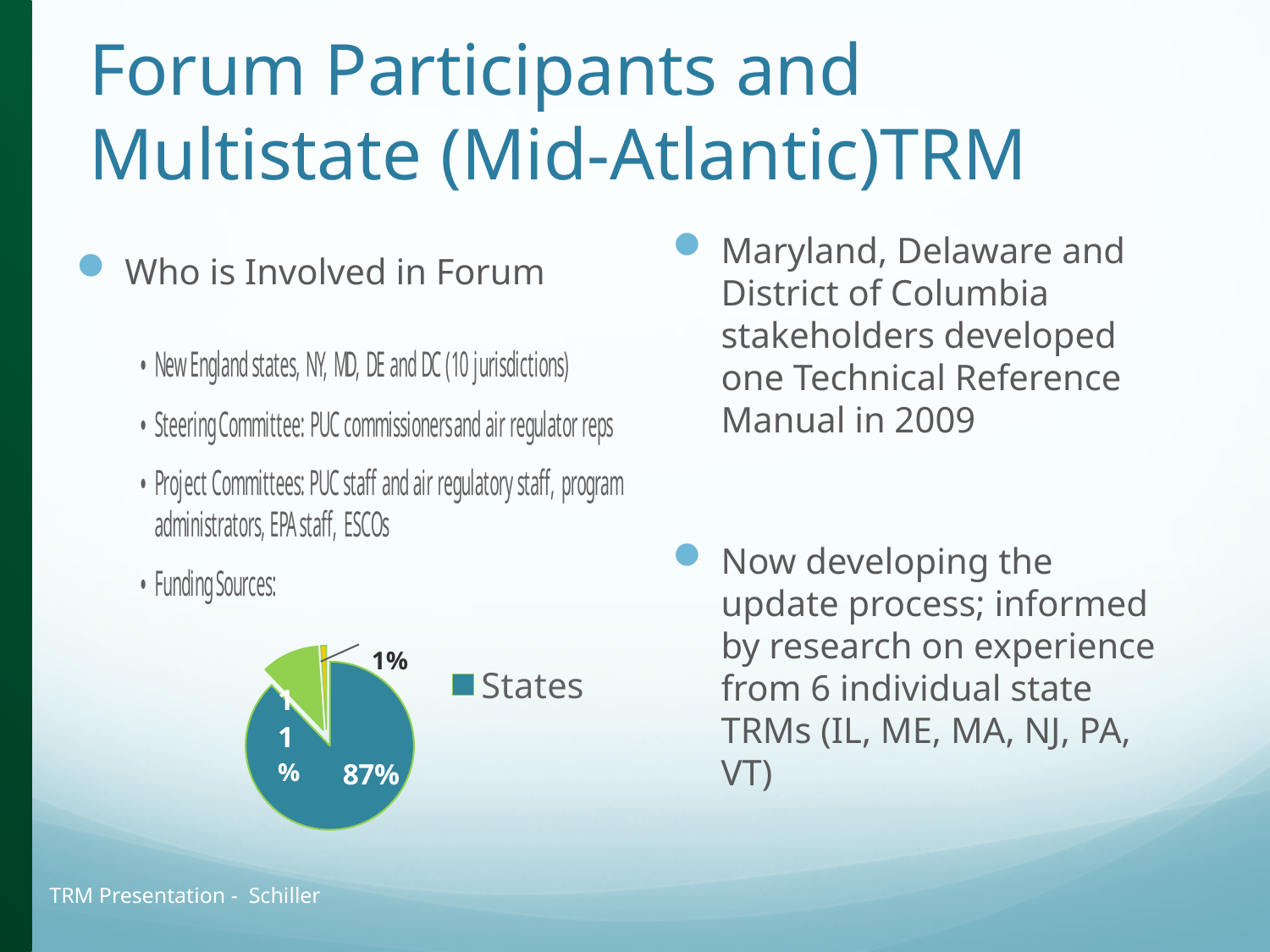
How many entries does the legend of the funding sources pie chart list? 1 What kind of chart is shown under "Funding Sources" on the slide? pie chart Is the States share in the funding sources pie chart greater or less than 50%? greater What colour is the States slice in the funding sources pie chart? teal What is the only entry shown in the legend of the funding sources pie chart? States Which category has the largest slice in the funding sources pie chart? States In the funding sources pie chart, which is larger: the States slice or the slice labeled 11%? States What percentage of the funding sources pie chart is labeled for States? 87% What is the difference between the States slice (87%) and the slice labeled 11% in the funding sources pie chart? 76% What is the smallest percentage label printed on the funding sources pie chart? 1%